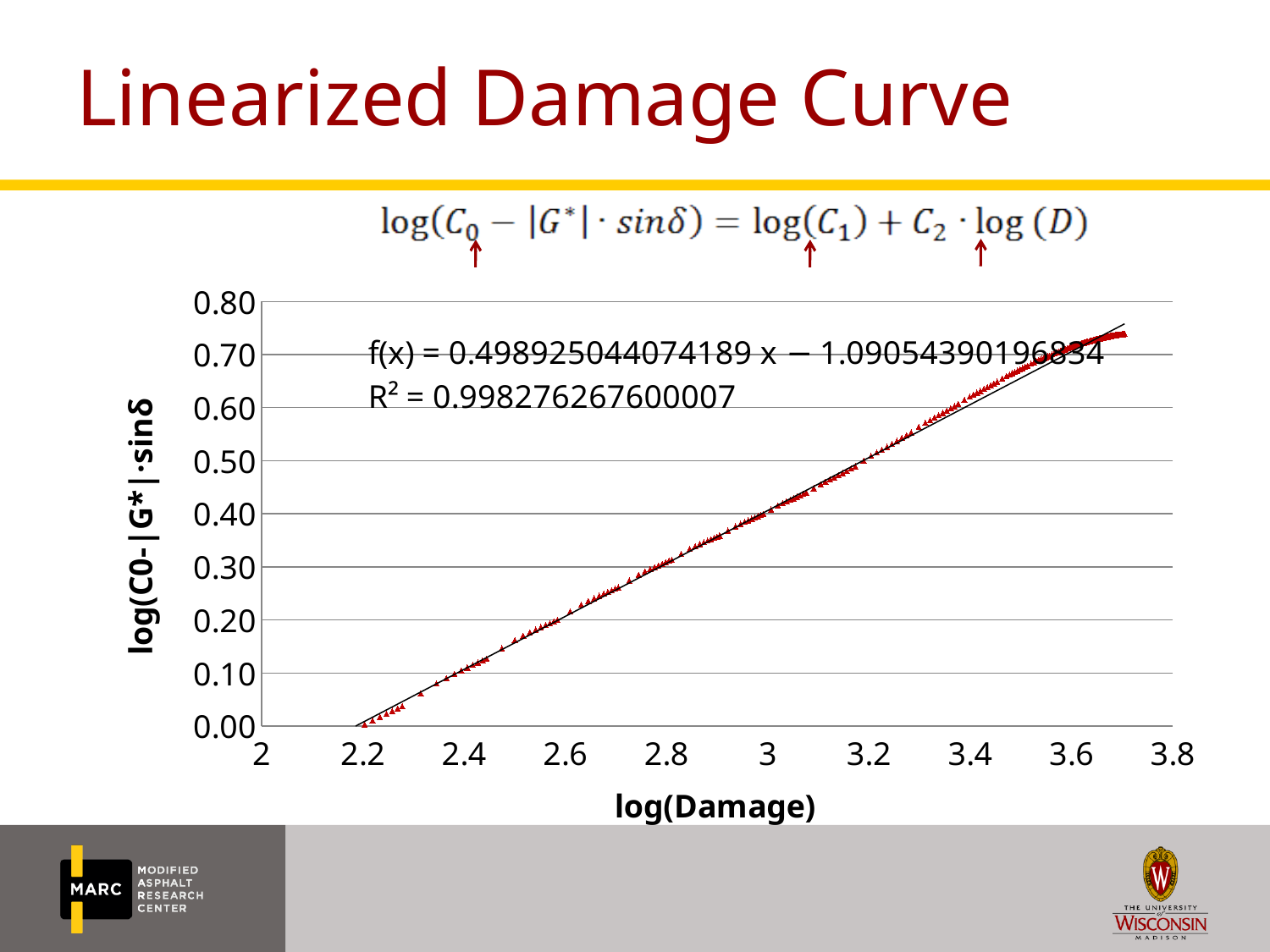
Do the plotted values rise or fall as log(Damage) increases along the x axis? rise Is the plotted value at log(Damage) = 3.2 greater or less than 0.40? greater What is the title of the x axis? log(Damage) Is the plotted value at log(Damage) = 2.8 greater or less than 0.50? less Is the plotted value at log(Damage) = 2.4 greater or less than 0.20? less What is the R² value printed on the chart? 0.998276267600007 Which has the larger plotted value, log(Damage) = 2.6 or log(Damage) = 3.4? 3.4 What kind of chart is shown on the slide? scatter chart